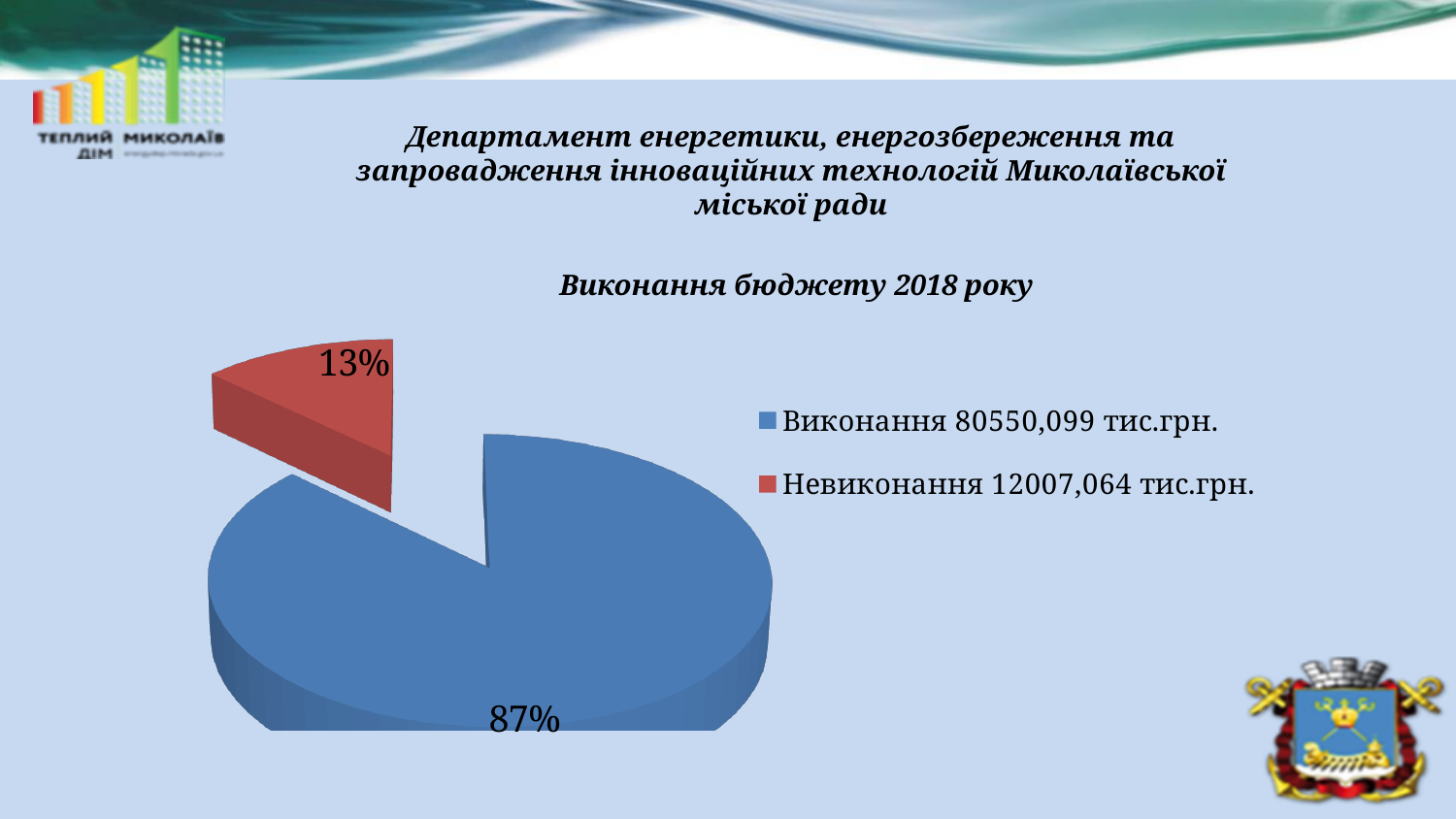
Which slice of the pie chart is the largest? Виконання What amount is shown in the legend for Виконання? 80550,099 тис.грн. What share of the pie does the Невиконання slice represent? 13% By how many percentage points does the Виконання share exceed the Невиконання share? 74 What kind of chart is shown on the slide? pie chart How many entries does the legend of the pie chart list? 2 Which slice of the pie chart is the smallest? Невиконання What is the title of the chart on the slide? Виконання бюджету 2018 року How many slices does the pie chart have? 2 Which is larger, the Виконання slice or the Невиконання slice? Виконання What share of the pie does the Виконання slice represent? 87% What amount is shown in the legend for Невиконання? 12007,064 тис.грн.